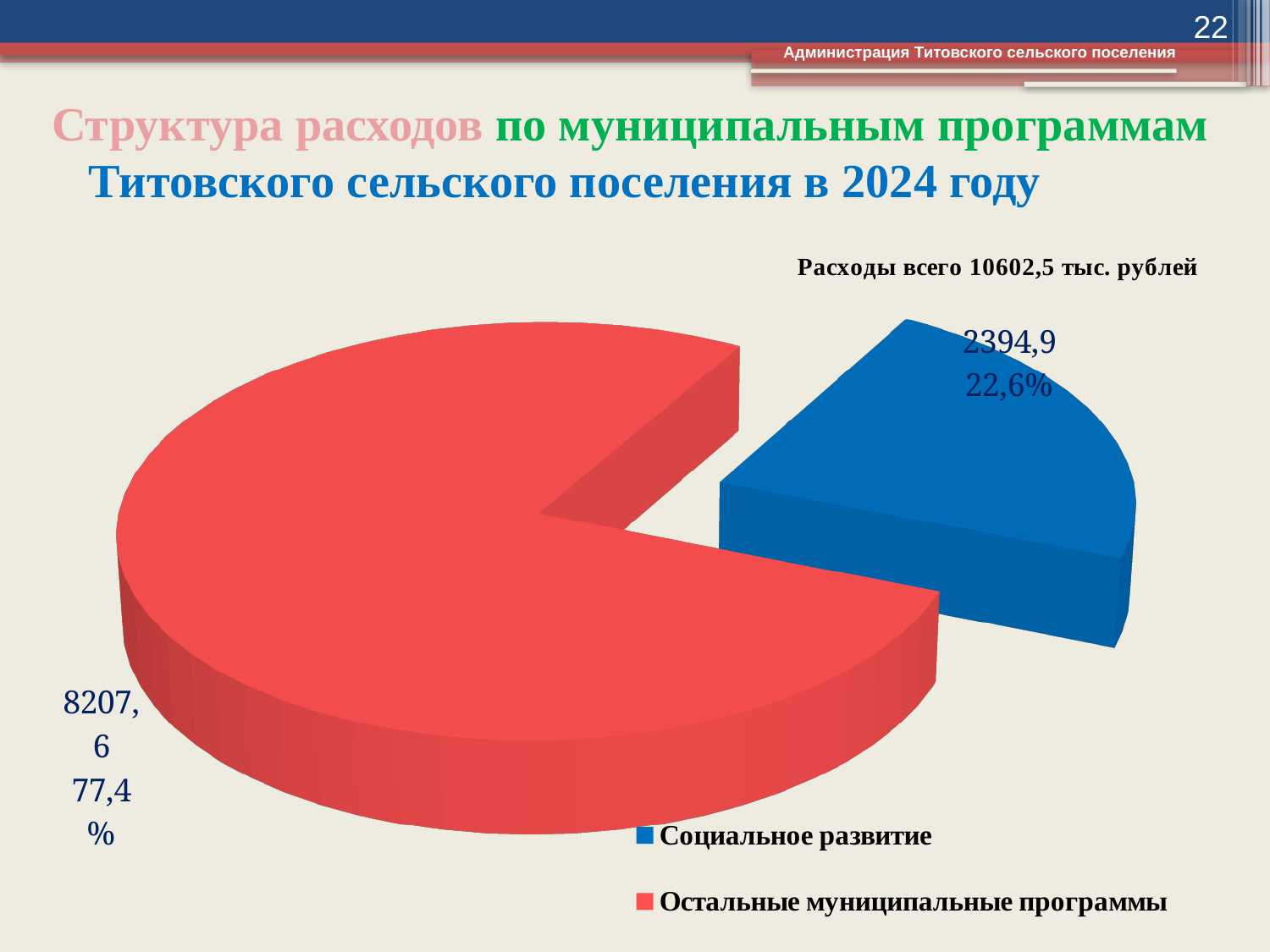
What share of the pie does Социальное развитие take? 22,6% What share of the pie does Остальные муниципальные программы take? 77,4% What is the value shown for Социальное развитие? 2394,9 How many entries does the legend list? 2 What kind of chart is shown on the slide? pie chart What colour is the slice for Социальное развитие? blue Which is larger, Социальное развитие or Остальные муниципальные программы? Остальные муниципальные программы How many slices does the pie chart have? 2 What is the value shown for Остальные муниципальные программы? 8207,6 Which slice is the smallest? Социальное развитие What is the difference between the values for Остальные муниципальные программы and Социальное развитие? 5812,7 Which slice is the largest? Остальные муниципальные программы